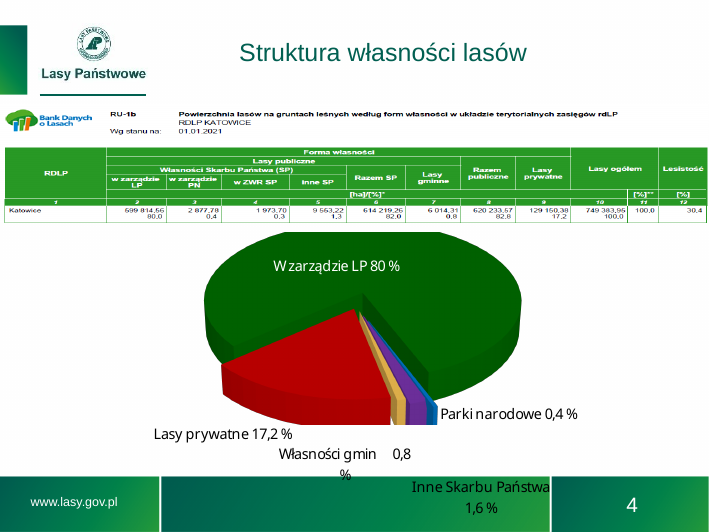
Which category has the smallest slice of the pie? Parki narodowe What is the difference between the shares of 'W zarządzie LP' and 'Lasy prywatne'? 62,8 % What value is shown for 'Parki narodowe'? 0,4 % What kind of chart is shown on the slide? Pie chart What share of the pie does 'W zarządzie LP' hold? 80 % Which category has the largest slice of the pie? W zarządzie LP What value is shown for 'Własności gmin'? 0,8 % How many categories are shown in the pie chart? 5 What value is shown for 'Inne Skarbu Państwa'? 1,6 % What share of the pie does 'Lasy prywatne' hold? 17,2 % Which is larger, the share of 'Inne Skarbu Państwa' or 'Własności gmin'? Inne Skarbu Państwa What is the title of the slide containing the chart? Struktura własności lasów